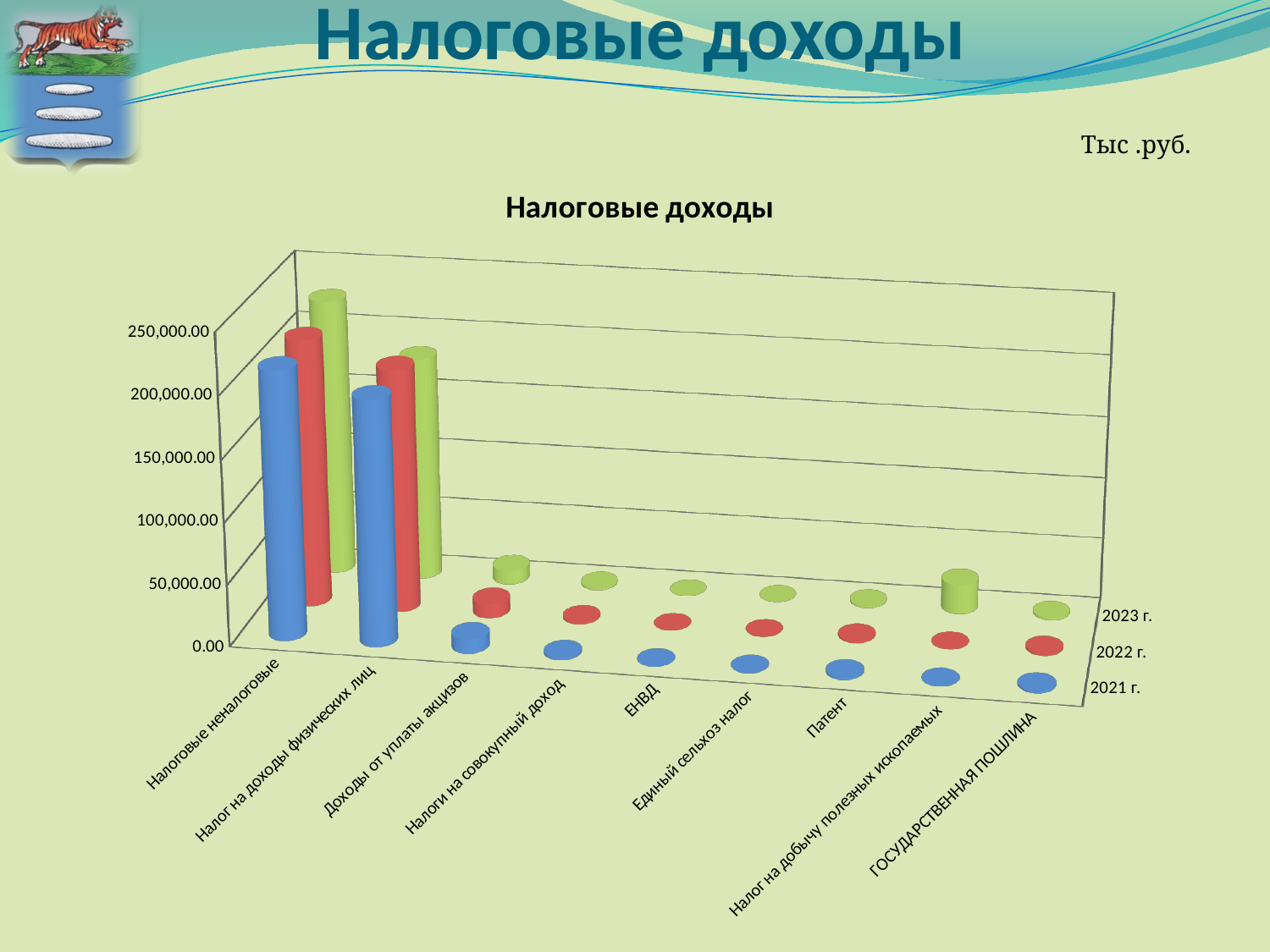
What is the title of the chart? Налоговые доходы Is the value for Налог на доходы физических лиц in 2021 г. greater or less than 100,000.00? greater In 2023 г., which is larger: the value for Налог на добычу полезных ископаемых or the value for Патент? Налог на добычу полезных ископаемых In 2021 г., which is larger: the value for Налоговые неналоговые or the value for ЕНВД? Налоговые неналоговые Moving from left to right along the x axis, do the values generally rise or fall? fall How many categories are shown along the x axis of the chart? 9 How many series (years) does the chart show? 3 Is the value for Налоговые неналоговые in 2021 г. greater or less than 100,000.00? greater Is the value for Патент in 2023 г. greater or less than 50,000.00? less What colour are the bars for the 2023 г. series? green What kind of chart is shown on the slide? bar chart